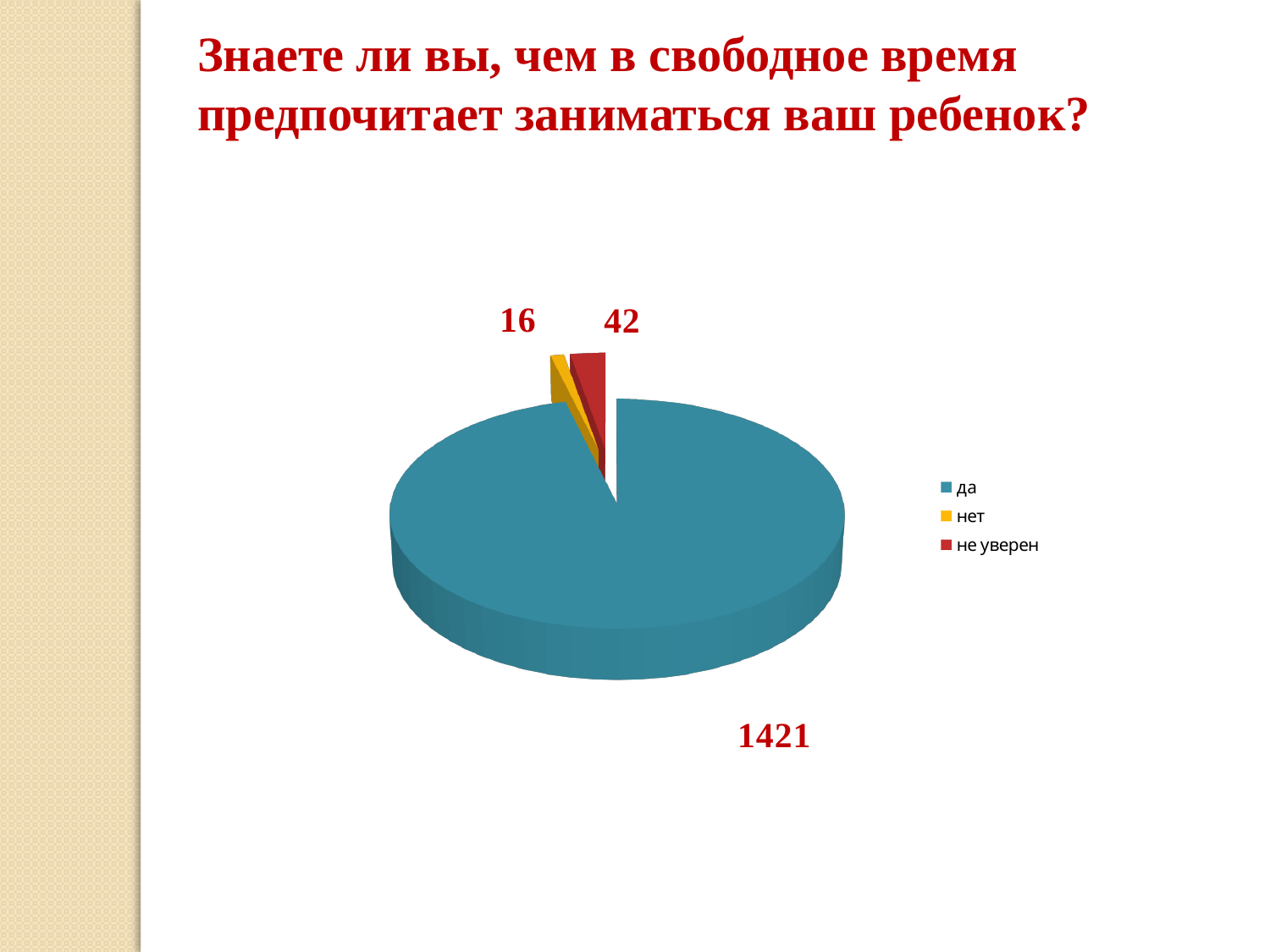
What is the value for the "да" slice? 1421 Which is larger, the value for "нет" or the value for "не уверен"? не уверен Which category has the largest slice? да What is the value for the "нет" slice? 16 What is the difference between the values for "да" and "не уверен"? 1379 What is the difference between the values for "не уверен" and "нет"? 26 What colour is the "да" slice? blue How many slices does the pie chart have? 3 Which category has the smallest slice? нет What is the value for the "не уверен" slice? 42 What kind of chart is shown on the slide? pie chart How many entries does the legend list? 3